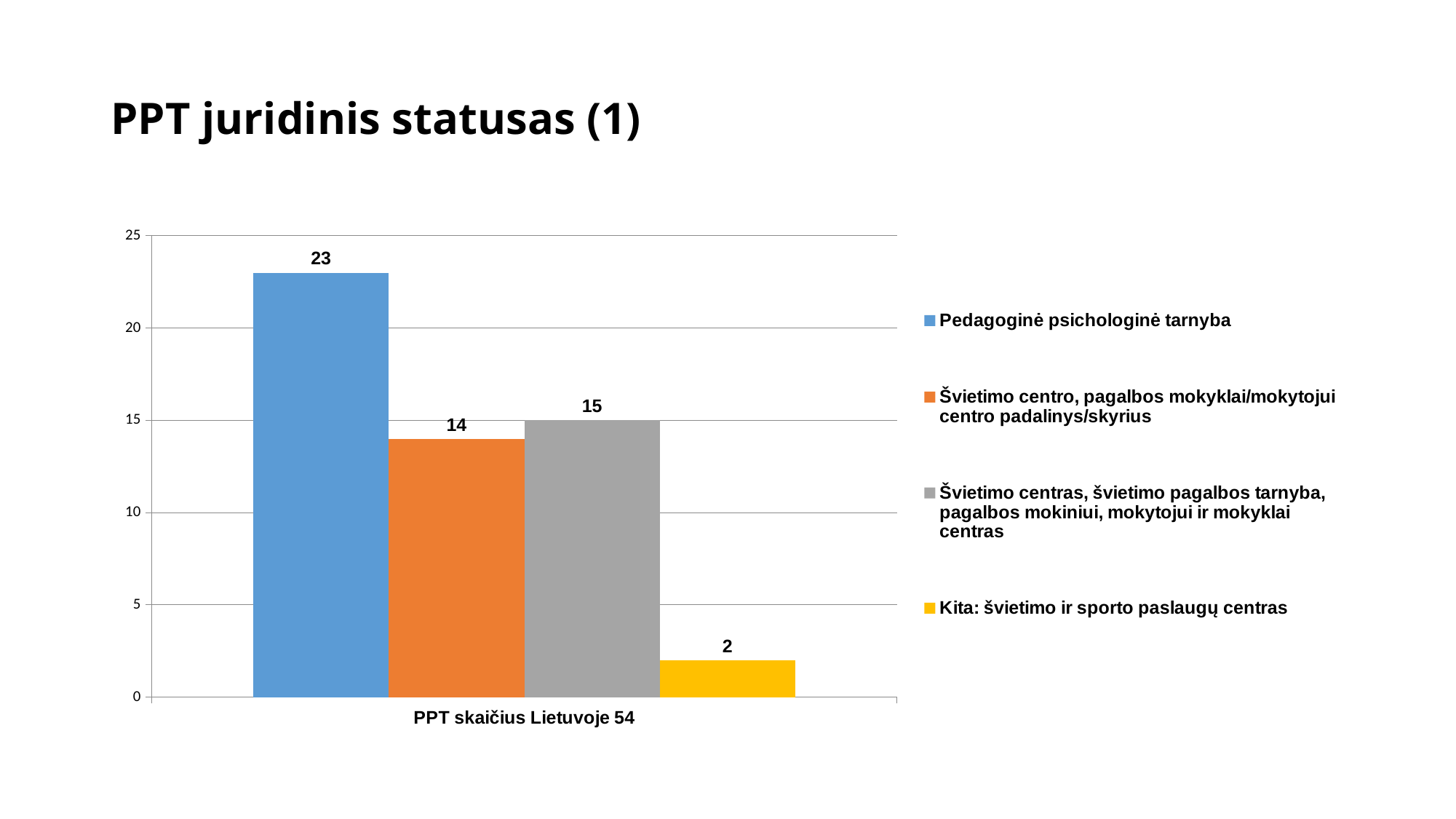
What is the value for Švietimo centras, švietimo pagalbos tarnyba, pagalbos mokiniui, mokytojui ir mokyklai centras? 15 What is the value for Pedagoginė psichologinė tarnyba? 23 What is the difference between the value for Pedagoginė psichologinė tarnyba and the value for Kita: švietimo ir sporto paslaugų centras? 21 How many series does the legend list? 4 What kind of chart is shown on the slide? bar chart Which series has the lowest value? Kita: švietimo ir sporto paslaugų centras Which is larger: the value for Švietimo centro, pagalbos mokyklai/mokytojui centro padalinys/skyrius or the value for Švietimo centras, švietimo pagalbos tarnyba, pagalbos mokiniui, mokytojui ir mokyklai centras? Švietimo centras, švietimo pagalbos tarnyba, pagalbos mokiniui, mokytojui ir mokyklai centras What is the label shown on the x axis of the chart? PPT skaičius Lietuvoje 54 What is the value for Kita: švietimo ir sporto paslaugų centras? 2 What is the value for Švietimo centro, pagalbos mokyklai/mokytojui centro padalinys/skyrius? 14 Is the value for Pedagoginė psichologinė tarnyba greater or less than 20? greater Which series has the highest value? Pedagoginė psichologinė tarnyba